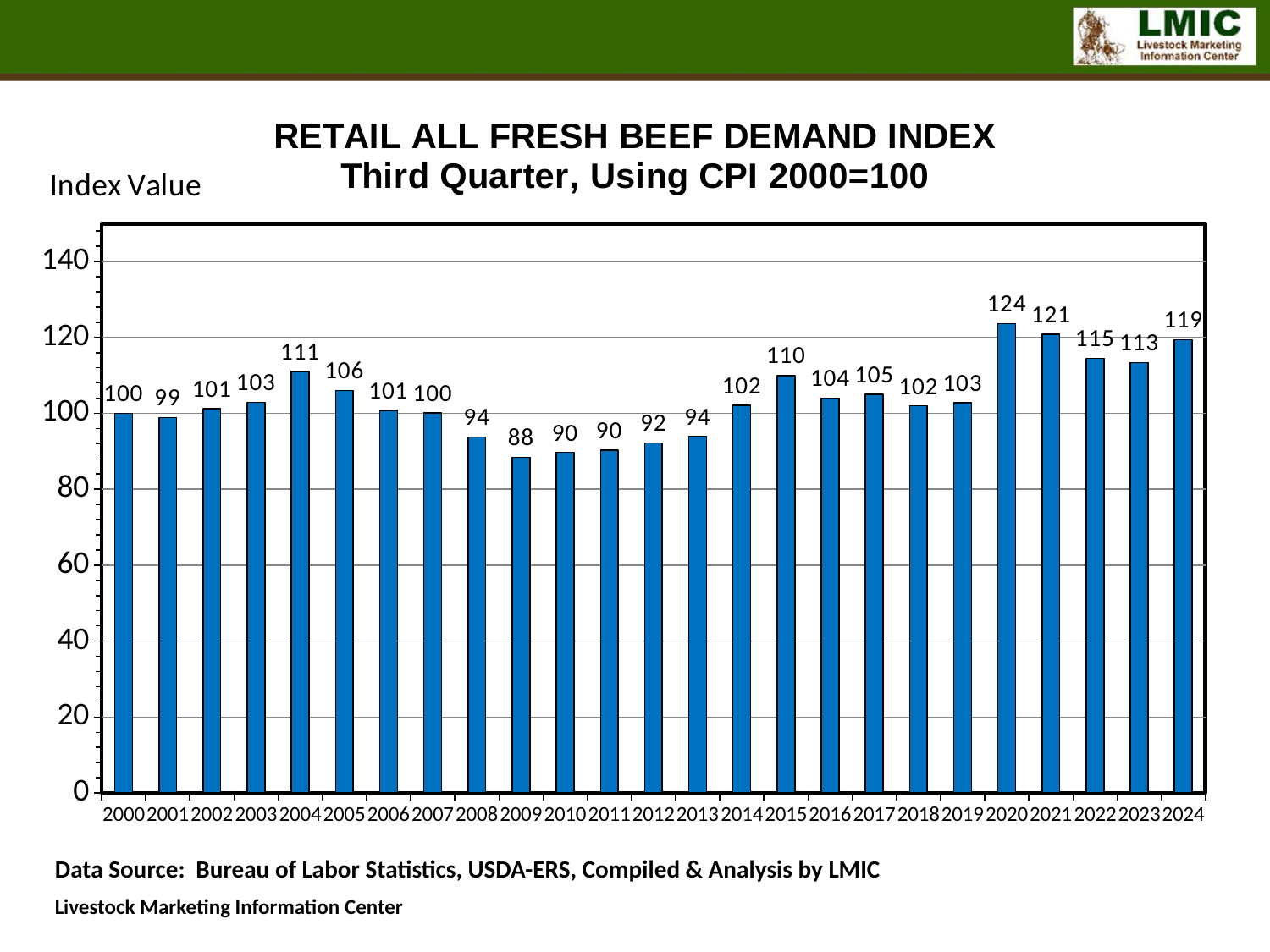
What is the difference between the index values for 2024 and 2023? 6 What is the difference between the index values for 2020 and 2009? 36 Which year has the highest index value? 2020 Which year has a larger index value, 2004 or 2015? 2004 What kind of chart is shown on the slide? Bar chart What is the index value for 2009? 88 What is the index value for 2024? 119 Do the index values rise or fall from 2020 to 2023? Fall Which year has the lowest index value? 2009 How many years are shown on the x axis? 25 Is the index value for 2021 greater or less than 120? greater What is the index value for 2020? 124